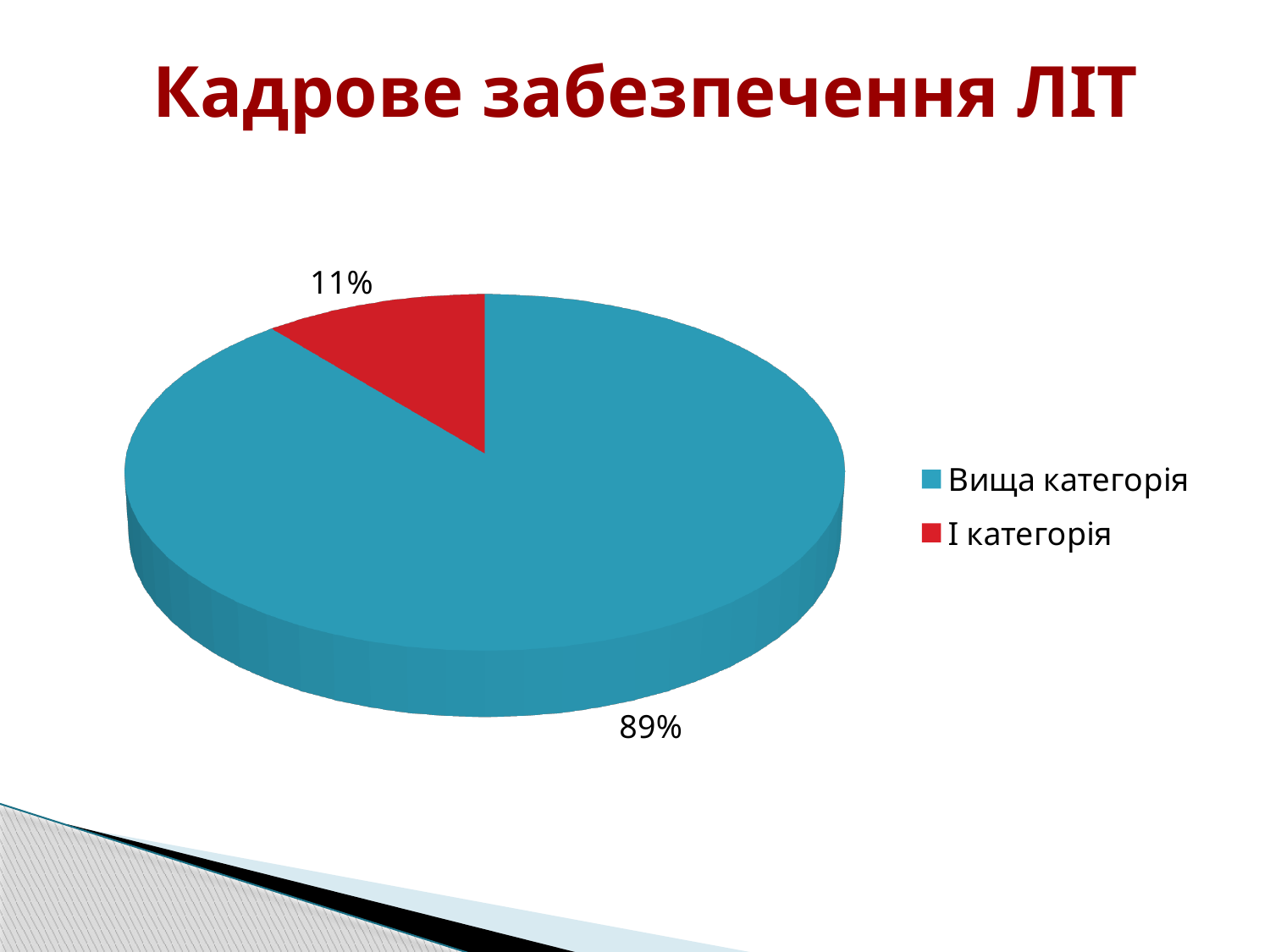
What is the difference between the shares of Вища категорія and І категорія? 78% Which is larger, the share for Вища категорія or for І категорія? Вища категорія What is the value for І категорія? 11% What is the value for Вища категорія? 89% What share of the pie does І категорія take? 11% What is the title of the slide containing the chart? Кадрове забезпечення ЛІТ What kind of chart is shown on the slide? pie chart Which category has the largest share of the pie? Вища категорія How many categories does the pie chart have? 2 How many entries does the legend list? 2 What colour is the slice for І категорія? red Which category has the smallest share of the pie? І категорія